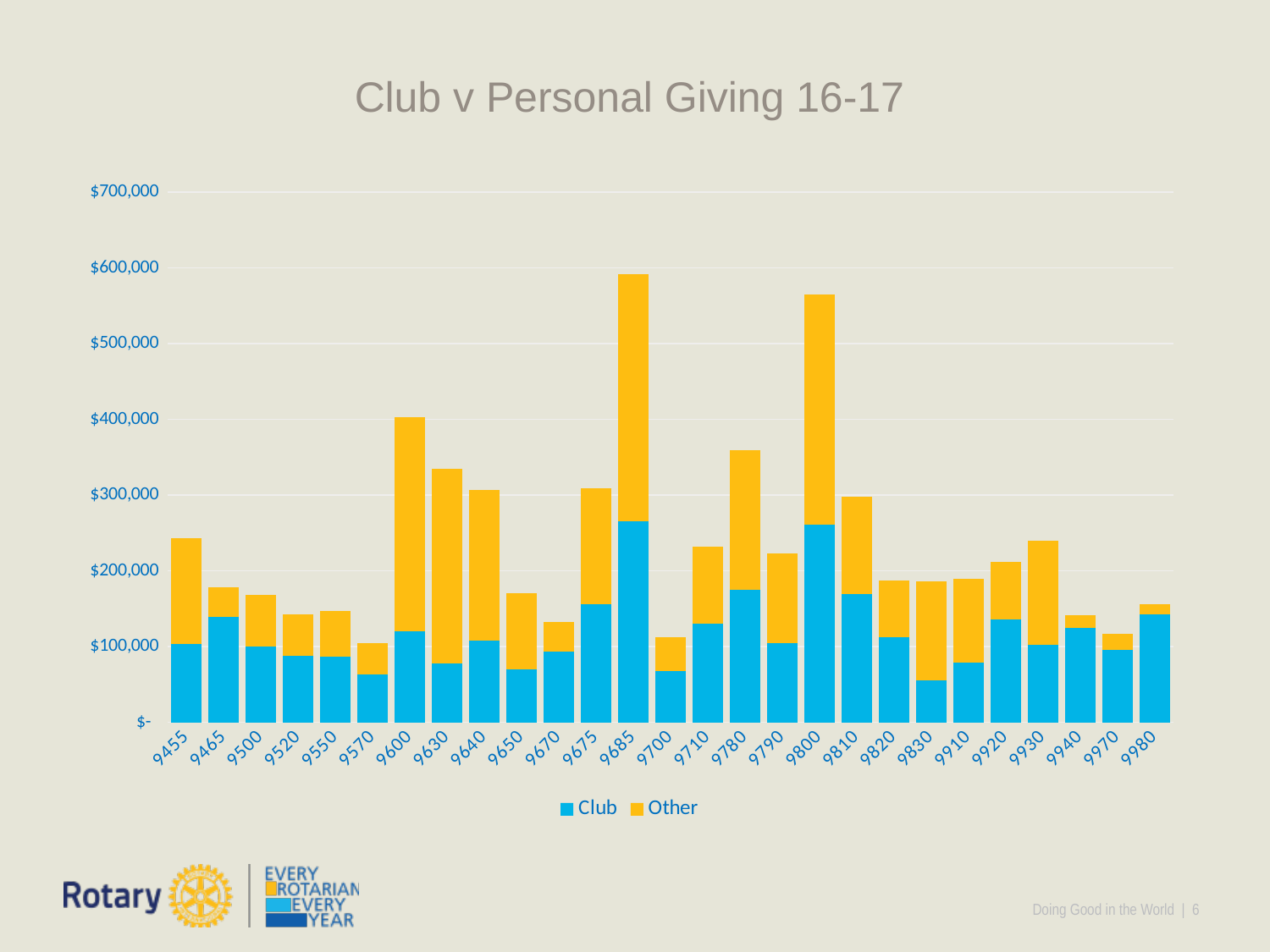
Which district has the larger total bar, 9600 or 9630? 9600 How many districts (categories) are shown along the x axis? 27 Is the total bar for district 9600 greater or less than $300,000? greater Is the Club value for district 9800 greater or less than $200,000? greater What is the title of the chart? Club v Personal Giving 16-17 How many series does the legend list? 2 Which district has the larger Club value, 9455 or 9465? 9465 Is the total bar for district 9685 greater or less than $500,000? greater What are the two series named in the legend? Club and Other Which district has the highest total bar? 9685 What kind of chart is shown on the slide? Stacked bar chart